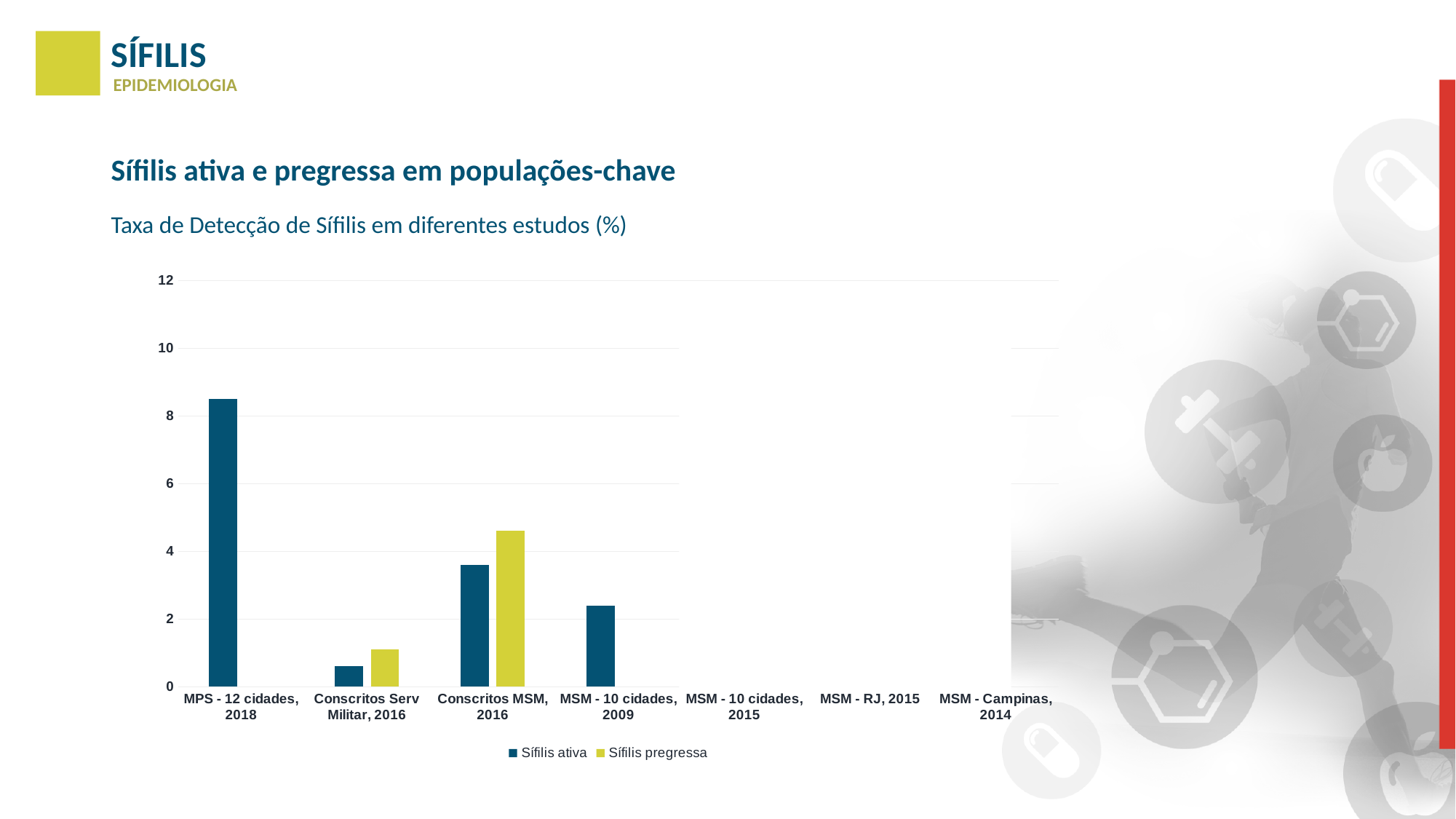
Is the Sífilis ativa value for Conscritos Serv Militar, 2016 greater or less than 2? less How many categories are shown on the x axis of the chart? 7 Which is larger: the Sífilis ativa value for MPS - 12 cidades, 2018 or for Conscritos MSM, 2016? MPS - 12 cidades, 2018 Which category has the highest value for Sífilis ativa? MPS - 12 cidades, 2018 Is the Sífilis ativa value for MSM - 10 cidades, 2009 greater or less than 2? greater Is the Sífilis pregressa value for Conscritos MSM, 2016 greater or less than 4? greater How many series does the legend list? 2 What is the title of the chart? Taxa de Detecção de Sífilis em diferentes estudos (%) For Conscritos MSM, 2016, which is larger: Sífilis ativa or Sífilis pregressa? Sífilis pregressa What kind of chart is shown on the slide? Bar chart Which series is shown in yellow-green bars? Sífilis pregressa